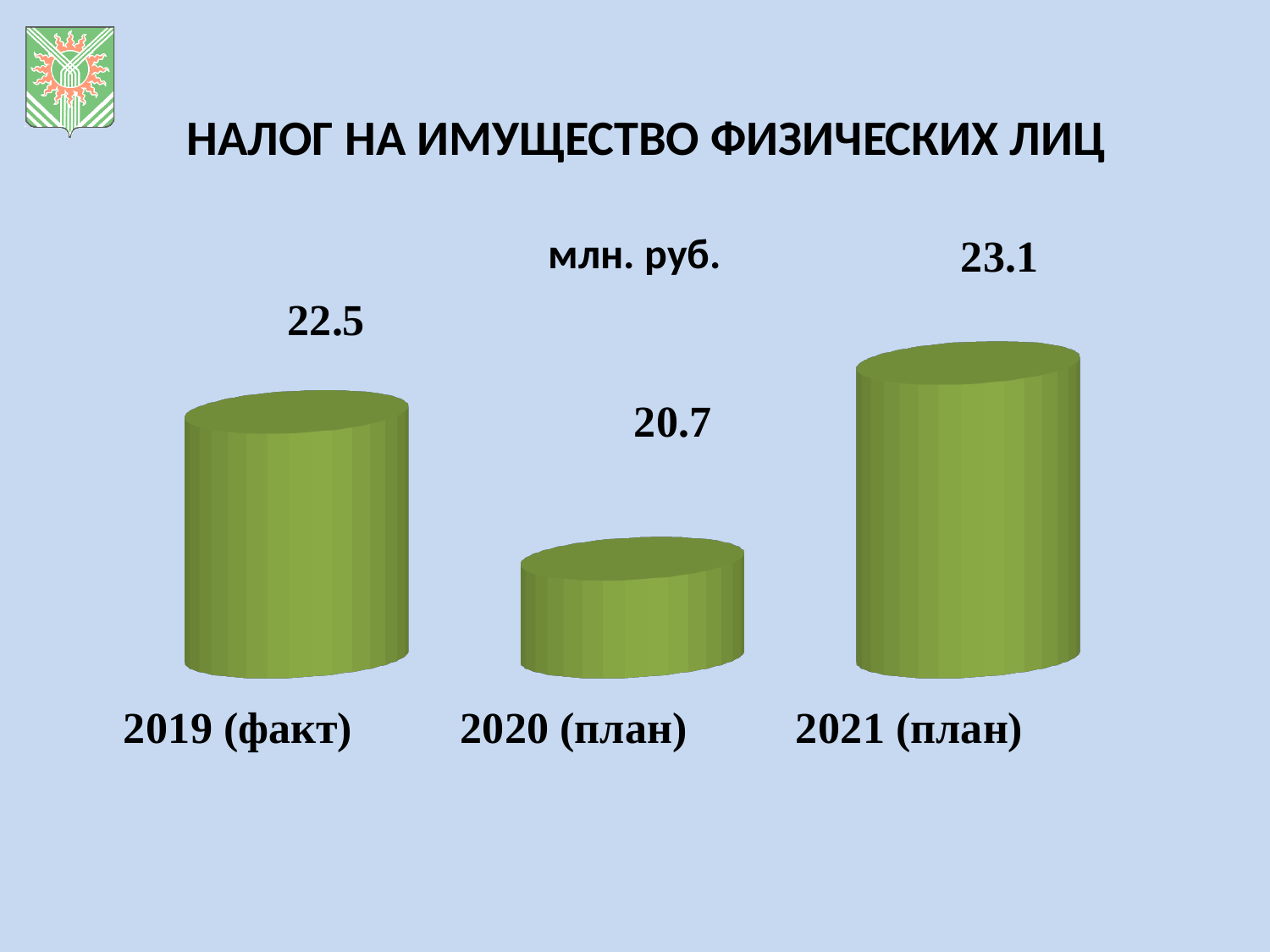
Which is larger, the value for 2019 (факт) or the value for 2021 (план)? 2021 (план) What is the difference between the values for 2021 (план) and 2020 (план)? 2.4 What kind of chart is shown on the slide? bar chart In what units are the values on the chart given? млн. руб. What is the title of the chart? НАЛОГ НА ИМУЩЕСТВО ФИЗИЧЕСКИХ ЛИЦ What is the value for 2019 (факт)? 22.5 How many categories are shown in the chart? 3 Which category has the lowest value? 2020 (план) What is the difference between the values for 2019 (факт) and 2020 (план)? 1.8 What is the value for 2021 (план)? 23.1 What is the value for 2020 (план)? 20.7 Which category has the highest value? 2021 (план)